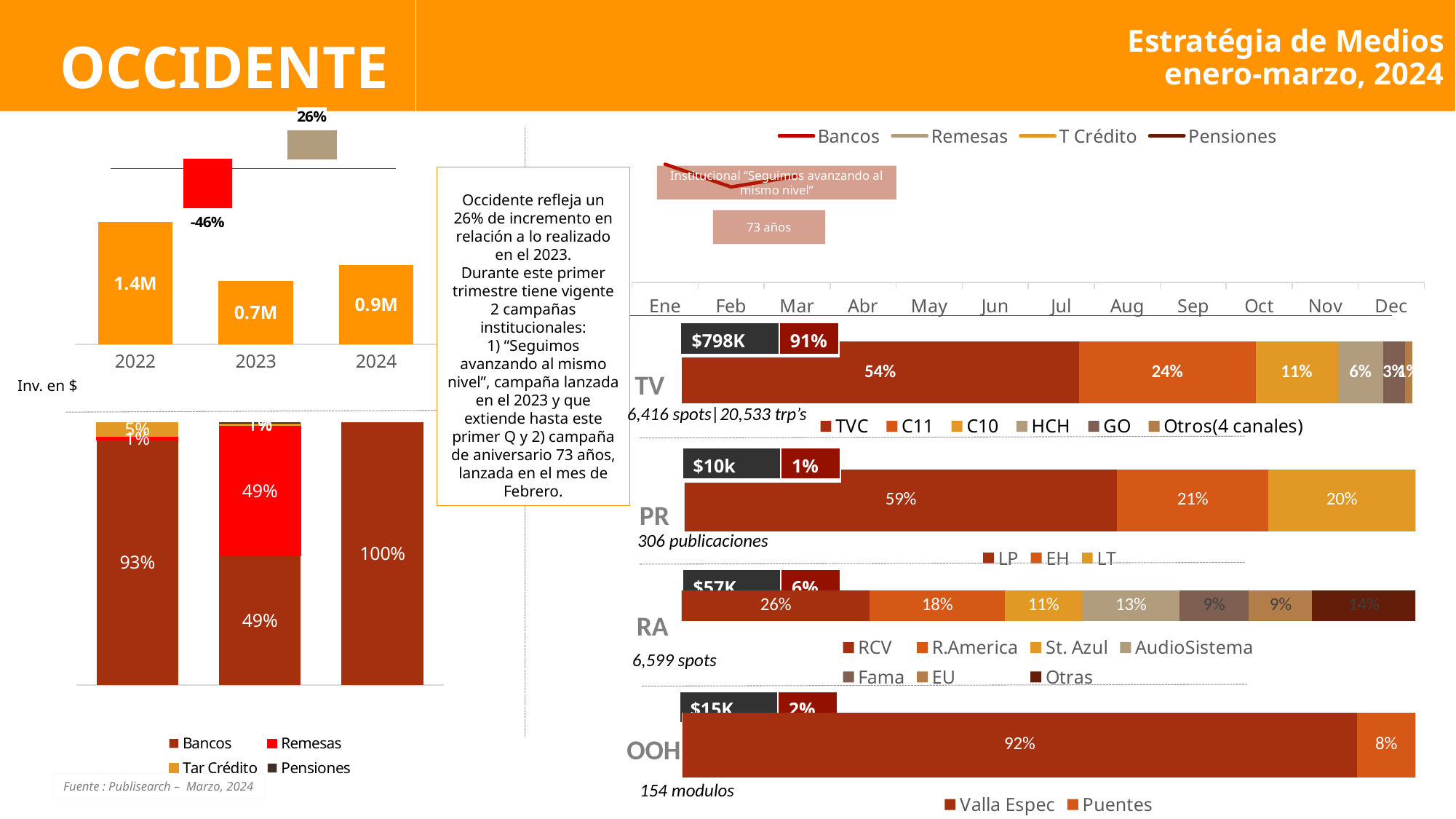
In the bottom-left stacked bar chart, what share does Remesas have in 2023? 49% In the RA bar on the right, which is larger, the share for RCV or the share for R.America? RCV In the bottom-left stacked bar chart, how many series does the legend list? 4 In the OOH bar on the right, what share does Puentes have? 8% In the top-left bar chart of investment by year, which year has the lowest value? 2023 In the top-left bar chart of investment by year, what percentage change is shown for 2024? 26% In the top-left bar chart of investment by year, what is the value for 2022? 1.4M In the top-left bar chart of investment by year, how many years are plotted? 3 In the TV bar on the right, which channel has the largest share? TVC In the bottom-left stacked bar chart, what share does Bancos have in 2024? 100% In the TV bar on the right, what share does C11 have? 24% In the PR bar on the right, what is the difference between the LP share and the EH share? 38%